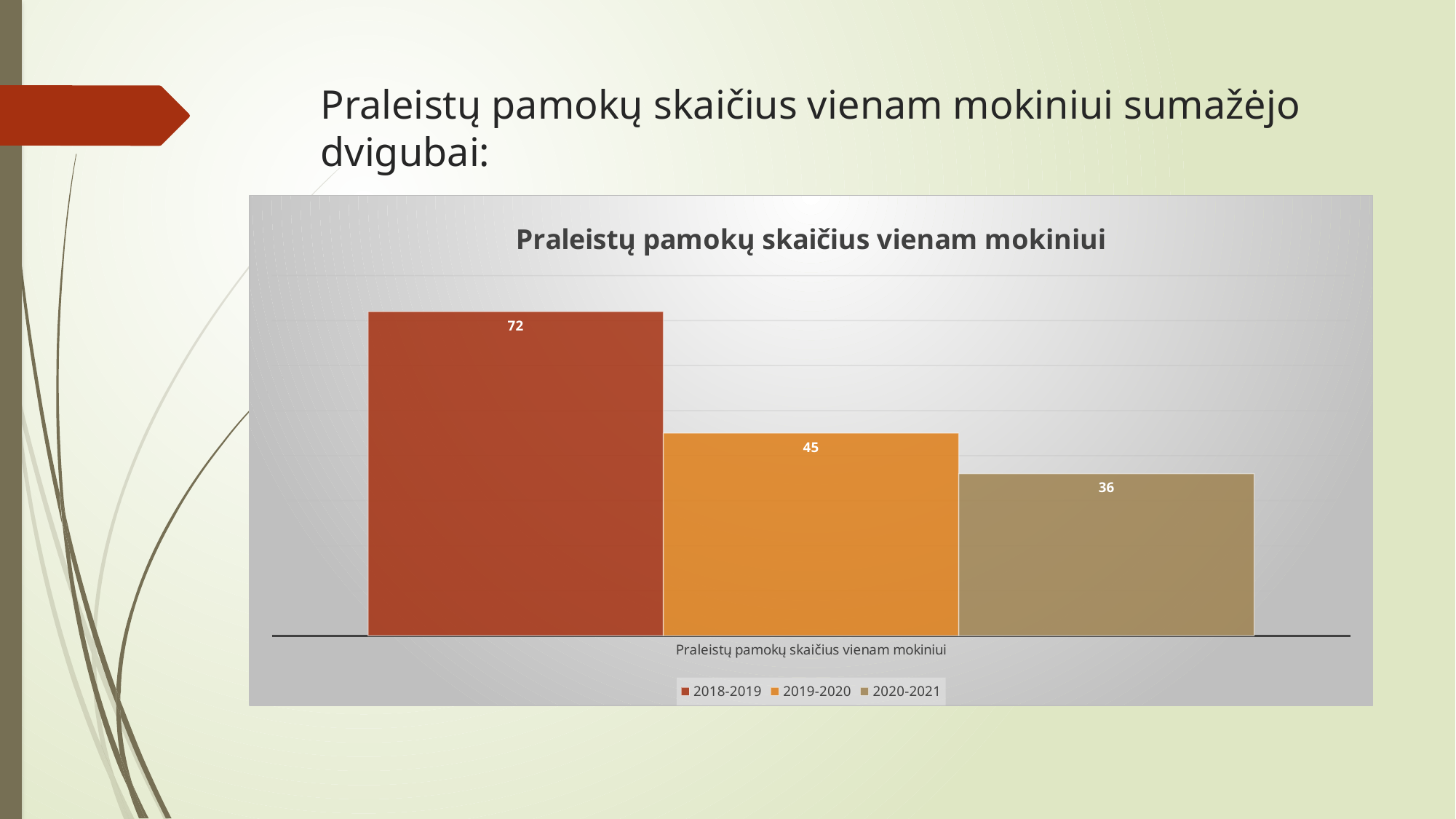
What kind of chart is shown? bar chart Do the values rise or fall from 2018-2019 to 2020-2021? fall What is the value for 2018-2019? 72 What is the value for 2019-2020? 45 Which series has the lowest value? 2020-2021 How many series does the legend list? 3 What is the title of the chart? Praleistų pamokų skaičius vienam mokiniui What is the difference between the values for 2018-2019 and 2020-2021? 36 What is the value for 2020-2021? 36 Which series has the highest value? 2018-2019 What is the difference between the values for 2019-2020 and 2020-2021? 9 Which is larger, the value for 2019-2020 or the value for 2020-2021? 2019-2020